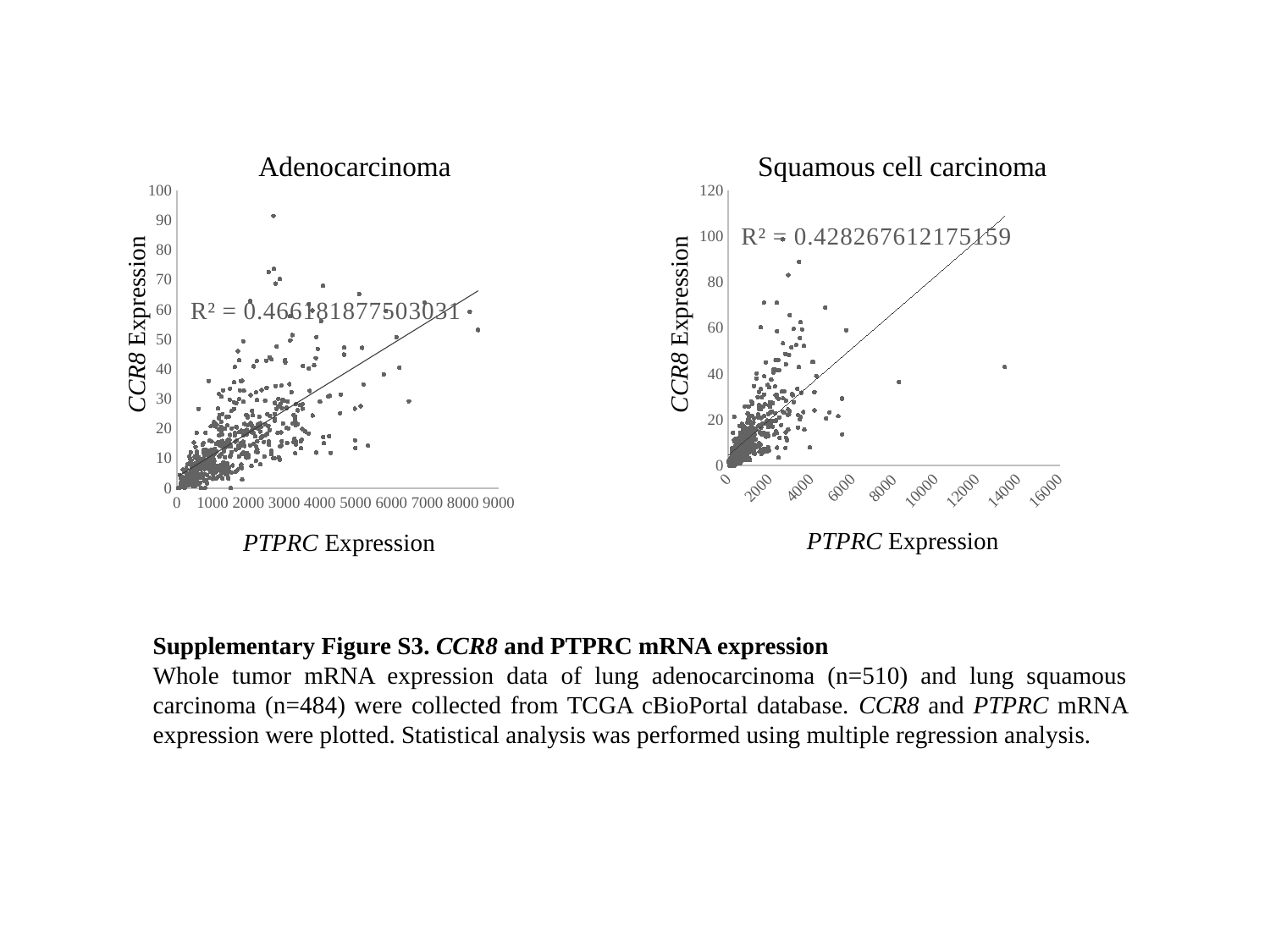
How many charts are shown on the slide? 2 Which chart shows the higher R² value, Adenocarcinoma or Squamous cell carcinoma? Adenocarcinoma What is the maximum value shown on the y-axis of the Squamous cell carcinoma chart? 120 In the Squamous cell carcinoma chart, is the highest CCR8 Expression value plotted greater or less than 100? less What is the x-axis label of the Adenocarcinoma chart? PTPRC Expression In the Adenocarcinoma chart, does CCR8 expression tend to rise or fall as PTPRC expression increases? rise In the Adenocarcinoma chart, is the highest CCR8 Expression value plotted greater or less than 80? greater What kind of chart is the Adenocarcinoma chart? scatter plot What R² value is printed on the Adenocarcinoma chart? 0.466181877503031 What R² value is printed on the Squamous cell carcinoma chart? 0.428267612175159 In the Squamous cell carcinoma chart, does CCR8 expression tend to rise or fall as PTPRC expression increases? rise What kind of chart is the Squamous cell carcinoma chart? scatter plot